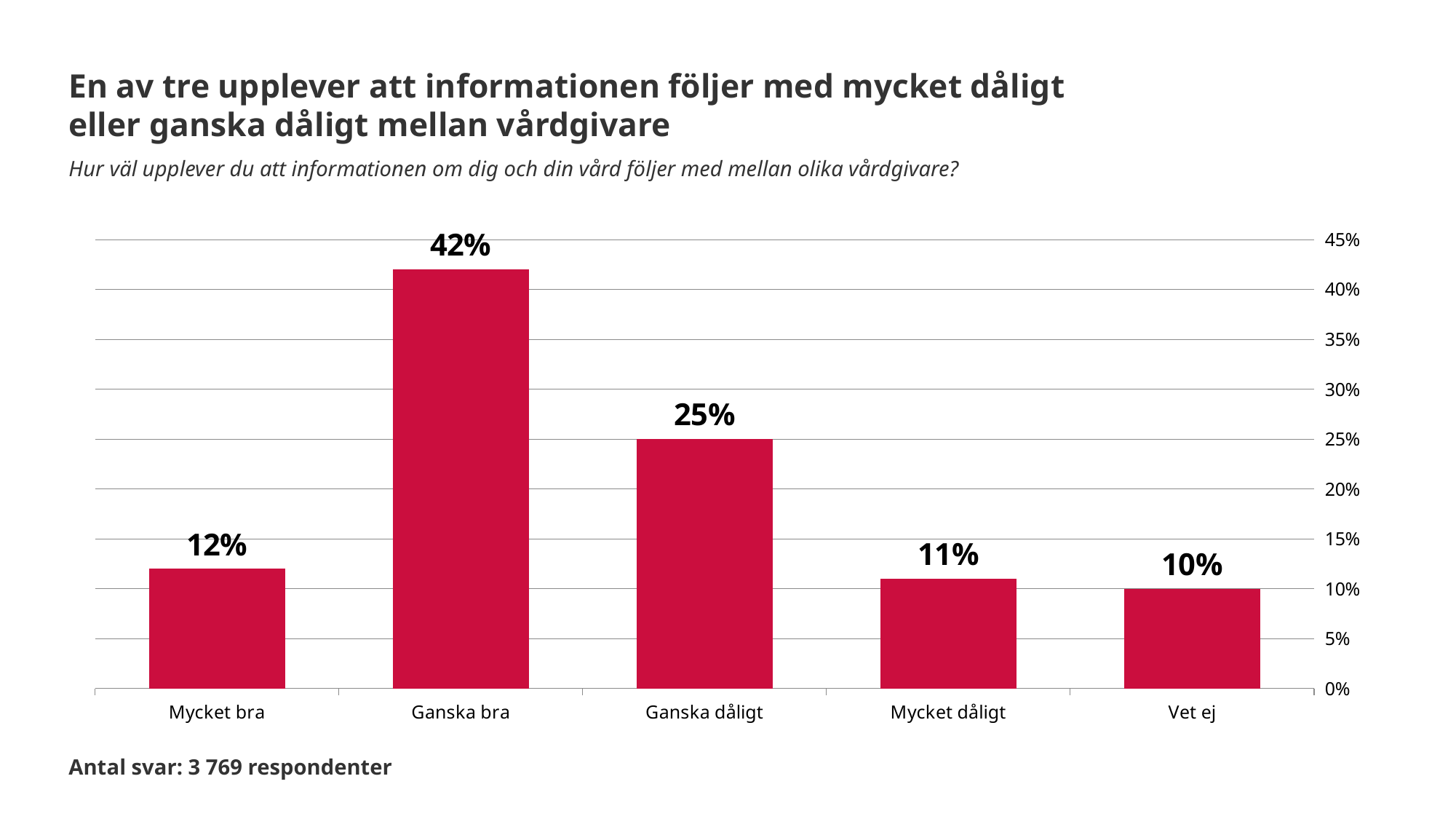
How many respondents answered the survey, according to the note below the chart? 3 769 What is the value for Ganska bra? 42% Which category has the lowest value? Vet ej Which category has the highest value? Ganska bra How many categories are shown on the x axis? 5 Which is larger, the value for Mycket bra or the value for Mycket dåligt? Mycket bra What kind of chart is shown on the slide? bar chart What is the value for Vet ej? 10% What is the difference between the values for Ganska bra and Ganska dåligt? 17% Is the value for Ganska bra greater or less than 40%? greater What is the value for Mycket bra? 12% What is the combined value of Ganska dåligt and Mycket dåligt? 36%